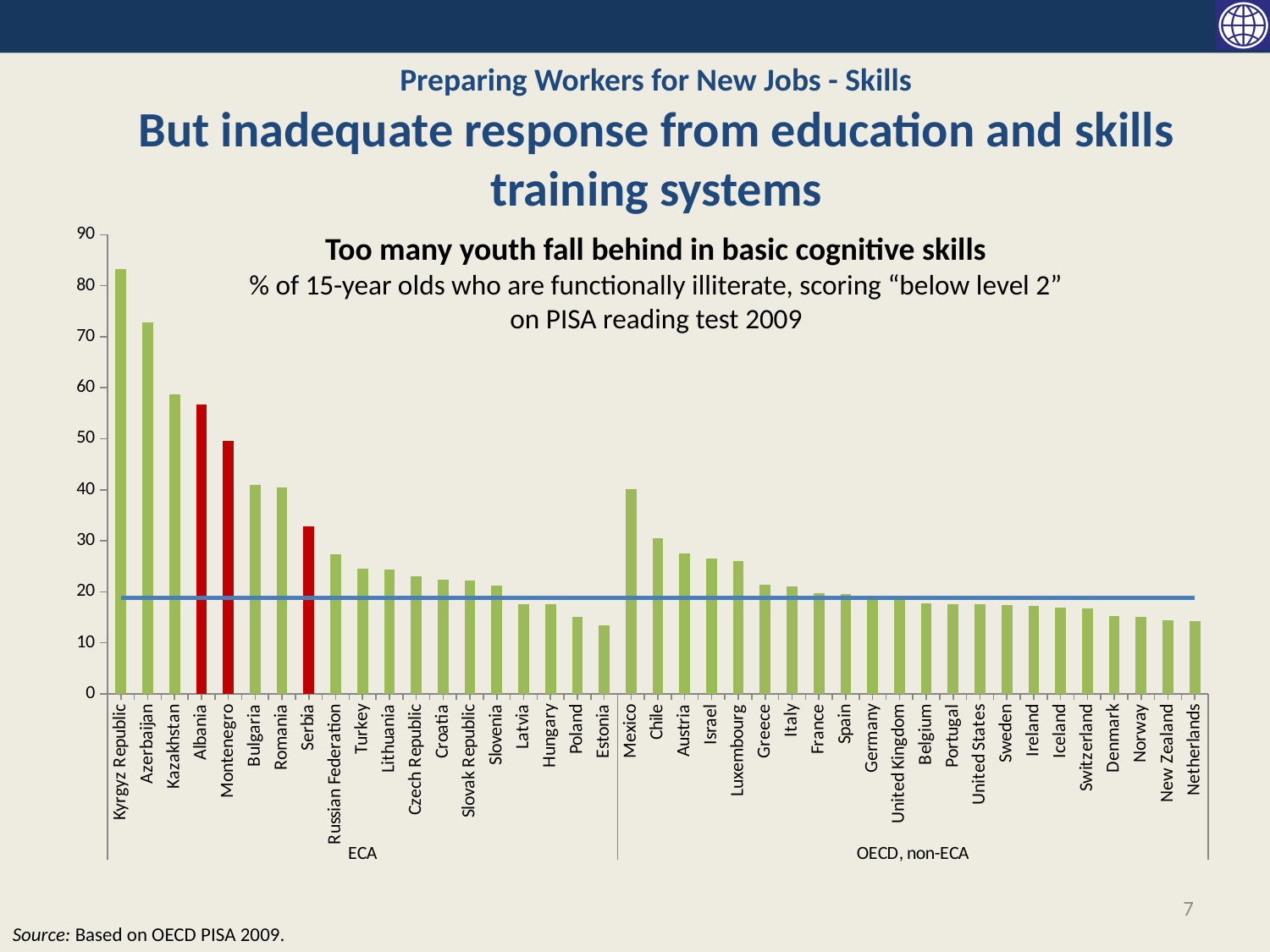
Is the value for Poland greater or less than 20? less How many countries are plotted in the chart? 41 What kind of chart is shown on the slide? bar chart Is the value for Albania greater or less than 50? greater Is the value for Russian Federation greater or less than 20? greater Within each country group, do the values rise or fall from left to right? fall Which country has the highest share of 15-year olds scoring below level 2 on the PISA reading test? Kyrgyz Republic Which has a higher value, Azerbaijan or Kazakhstan? Azerbaijan Which countries are shown with red bars? Albania, Montenegro, Serbia Which has a higher value, Mexico or Chile? Mexico